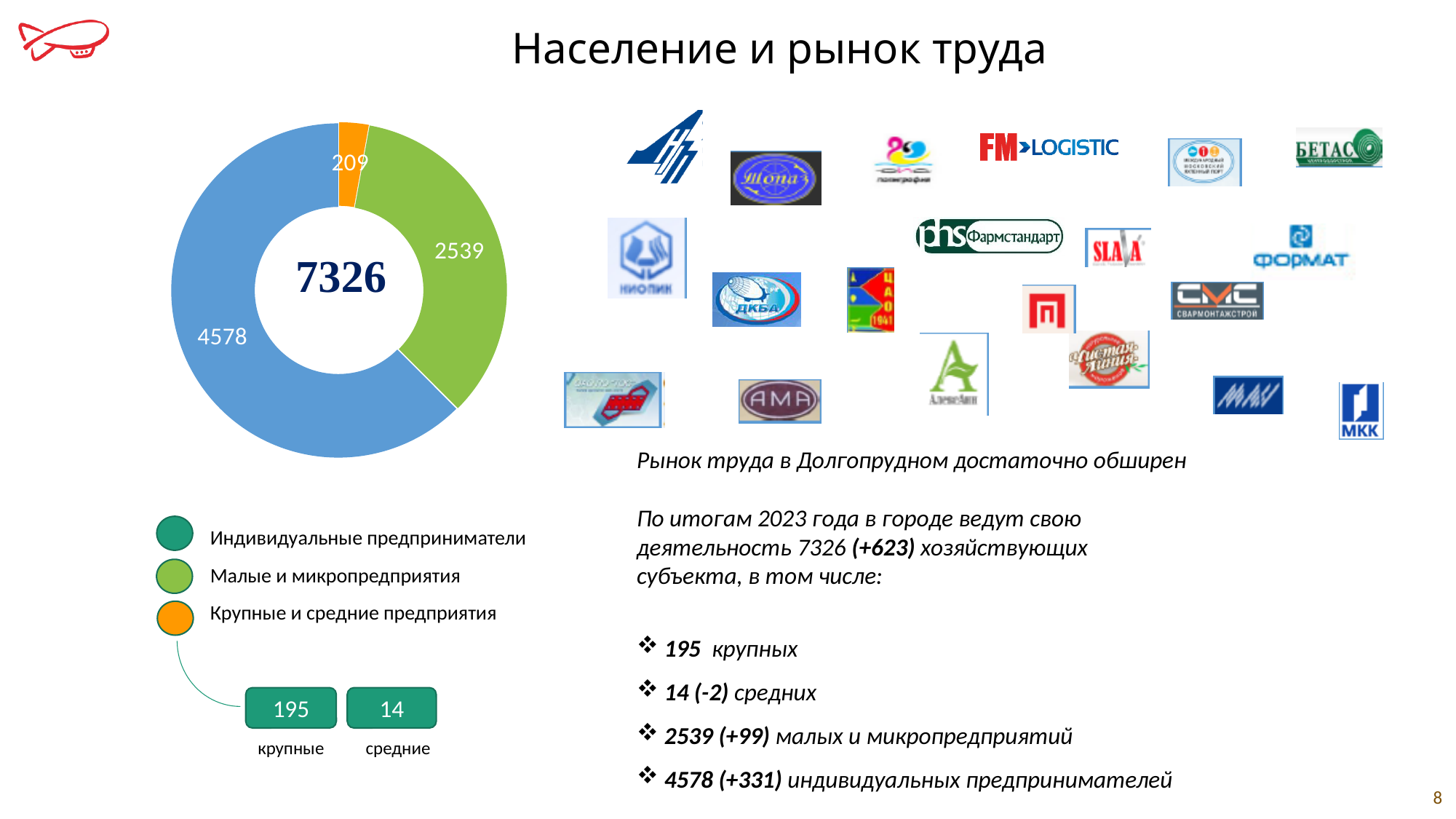
Which category has the largest segment in the donut chart? Индивидуальные предприниматели What is the total of all segments in the donut chart? 7326 How many segments does the donut chart have? 3 What value is shown for the green segment (Малые и микропредприятия) of the donut chart? 2539 Which is larger in the donut chart: Малые и микропредприятия or Крупные и средние предприятия? Малые и микропредприятия What value is shown for the orange segment (Крупные и средние предприятия) of the donut chart? 209 What value is shown for the blue segment of the donut chart? 4578 What is the difference between the green segment (2539) and the orange segment (209) in the donut chart? 2330 What is the difference between the blue segment (4578) and the green segment (2539) in the donut chart? 2039 Which category has the smallest segment in the donut chart? Крупные и средние предприятия What number is printed in the centre of the donut chart? 7326 What type of chart is shown on the slide? Donut (pie) chart